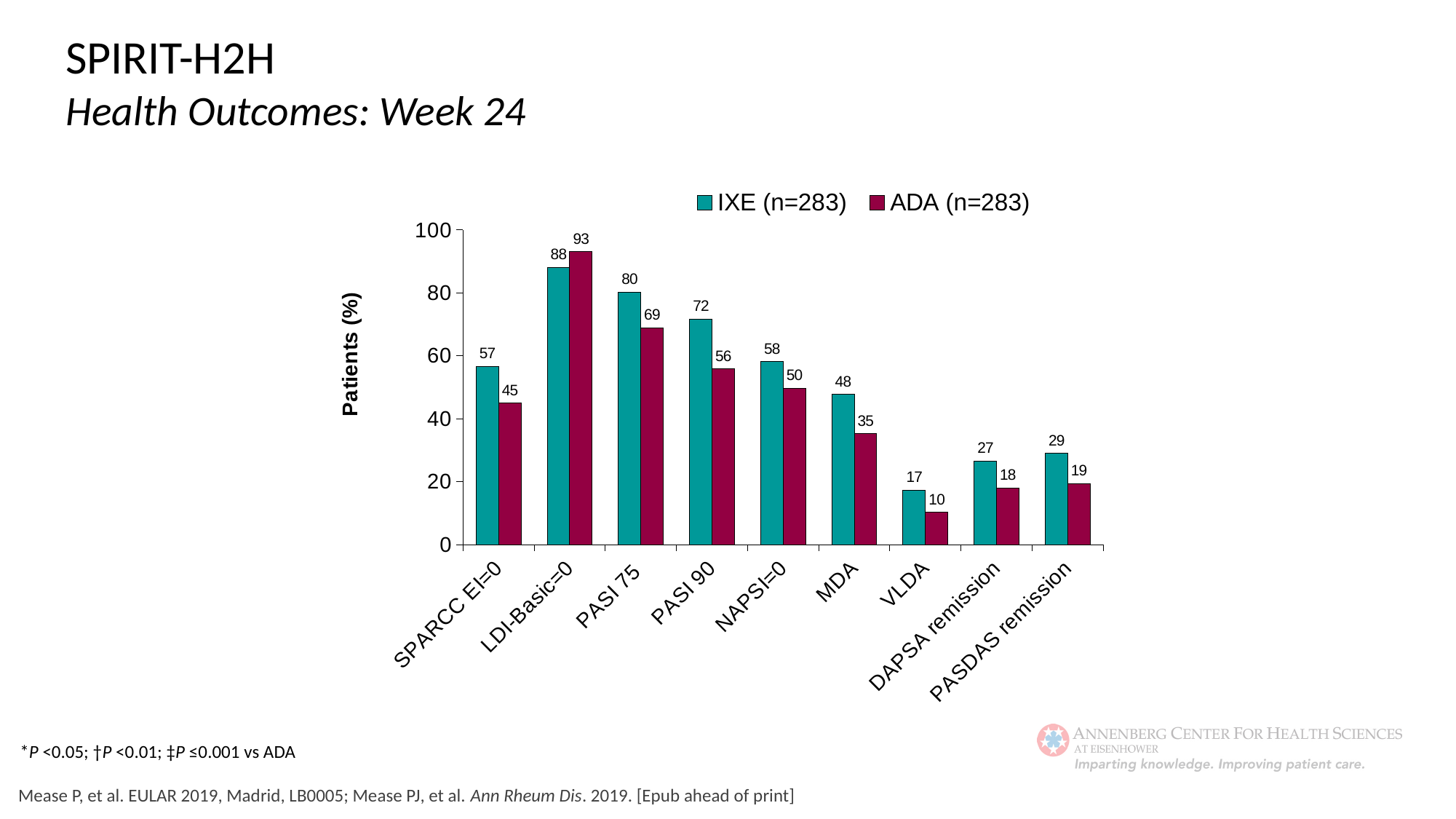
What is the difference between the IXE (n=283) and ADA (n=283) values for SPARCC EI=0? 12 Which category has the highest value for IXE (n=283)? LDI-Basic=0 How many series does the legend list? 2 What is the value for ADA (n=283) for VLDA? 10 How many categories are shown on the x axis? 9 For LDI-Basic=0, which series has the larger value, IXE (n=283) or ADA (n=283)? ADA (n=283) What is the difference between the IXE (n=283) and ADA (n=283) values for PASI 90? 16 What is the value for ADA (n=283) for MDA? 35 What is the label of the y axis? Patients (%) What kind of chart is shown on the slide? Bar chart Which category has the lowest value for ADA (n=283)? VLDA What is the value for IXE (n=283) for PASI 75? 80